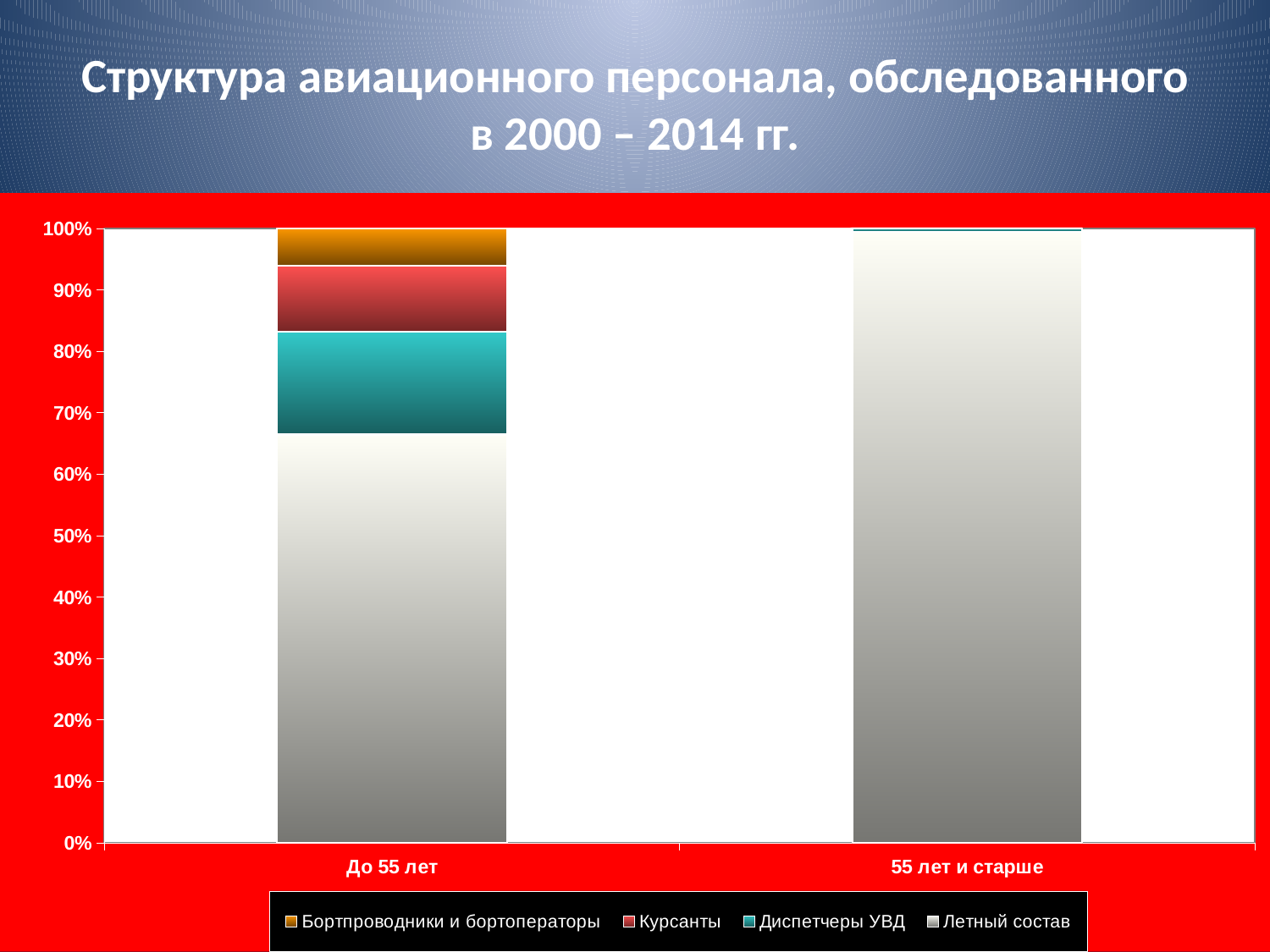
How many series does the chart legend list? 4 Which series makes up the smallest share of the bar for До 55 лет? Бортпроводники и бортоператоры Is the share of Летный состав larger in the 55 лет и старше bar or in the До 55 лет bar? 55 лет и старше Is the share of Летный состав in the До 55 лет bar greater or less than 70%? less How many categories are shown on the x axis of the chart? 2 Which series makes up the largest share of the bar for До 55 лет? Летный состав Is the share of Диспетчеры УВД in the До 55 лет bar greater or less than 10%? greater Which series is shown in orange in the chart legend? Бортпроводники и бортоператоры What is the title of the chart on the slide? Структура авиационного персонала, обследованного в 2000 – 2014 гг. What is the total height of the stacked bar for 55 лет и старше? 100% What kind of chart is shown on the slide? Stacked bar chart Is the share of Летный состав in the До 55 лет bar greater or less than 60%? greater